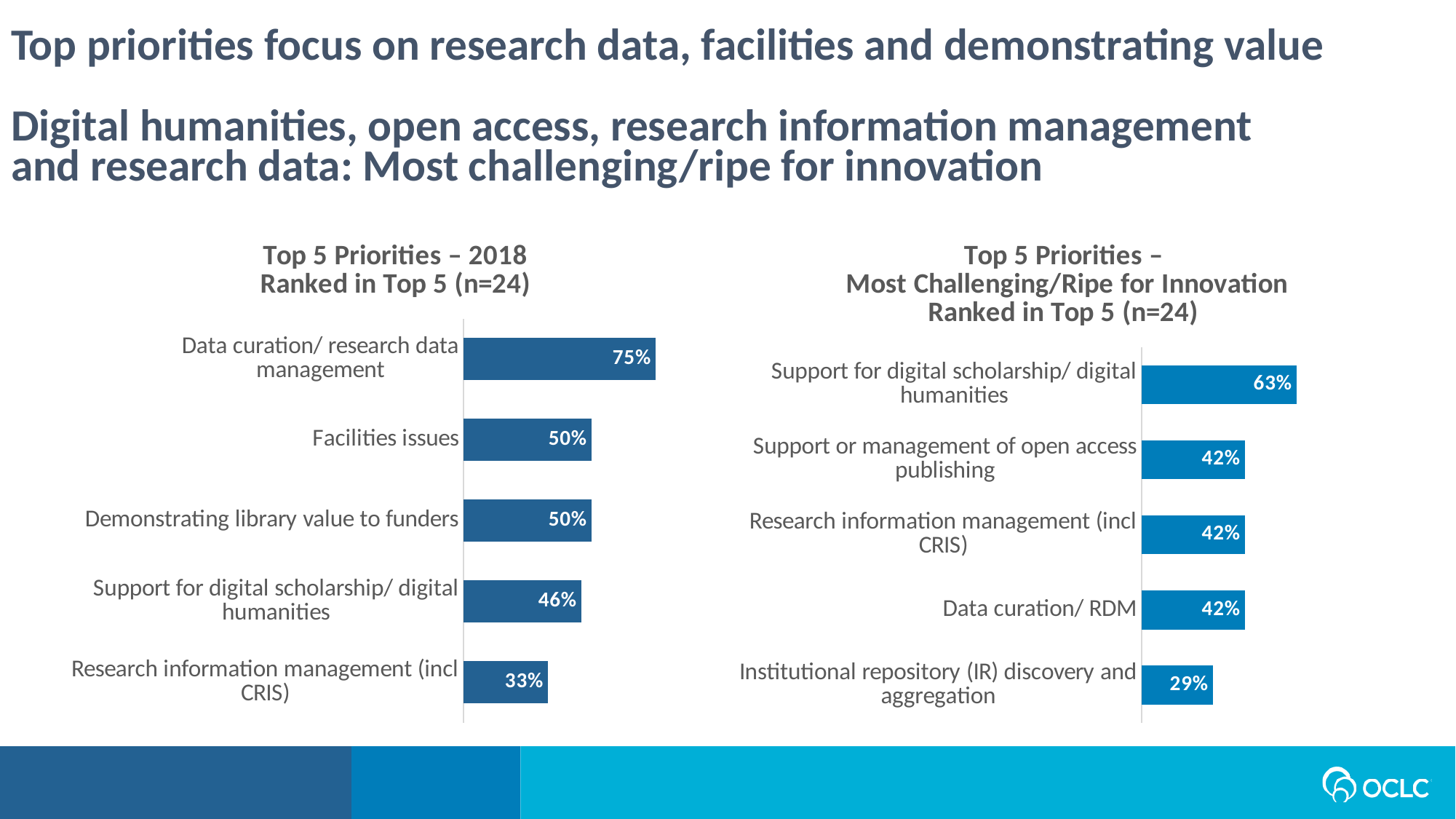
In the left chart (Top 5 Priorities – 2018), what is the value for Research information management (incl CRIS)? 33% In the right chart (Most Challenging/Ripe for Innovation), which category has the lowest value? Institutional repository (IR) discovery and aggregation In the left chart (Top 5 Priorities – 2018), what is the value for Data curation/ research data management? 75% In the left chart (Top 5 Priorities – 2018), what is the difference between Data curation/ research data management and Facilities issues? 25% In the right chart (Most Challenging/Ripe for Innovation), what is the value for Support for digital scholarship/ digital humanities? 63% In the left chart (Top 5 Priorities – 2018), which is larger: Support for digital scholarship/ digital humanities or Research information management (incl CRIS)? Support for digital scholarship/ digital humanities In the right chart (Most Challenging/Ripe for Innovation), what is the difference between Support for digital scholarship/ digital humanities and Data curation/ RDM? 21% What is the sample size (n) stated in the title of the left chart? n=24 In the right chart (Most Challenging/Ripe for Innovation), what is the value for Institutional repository (IR) discovery and aggregation? 29% In the left chart (Top 5 Priorities – 2018), which category has the highest value? Data curation/ research data management What type of chart is the left chart (Top 5 Priorities – 2018)? Bar chart How many categories are shown in the right chart (Most Challenging/Ripe for Innovation)? 5